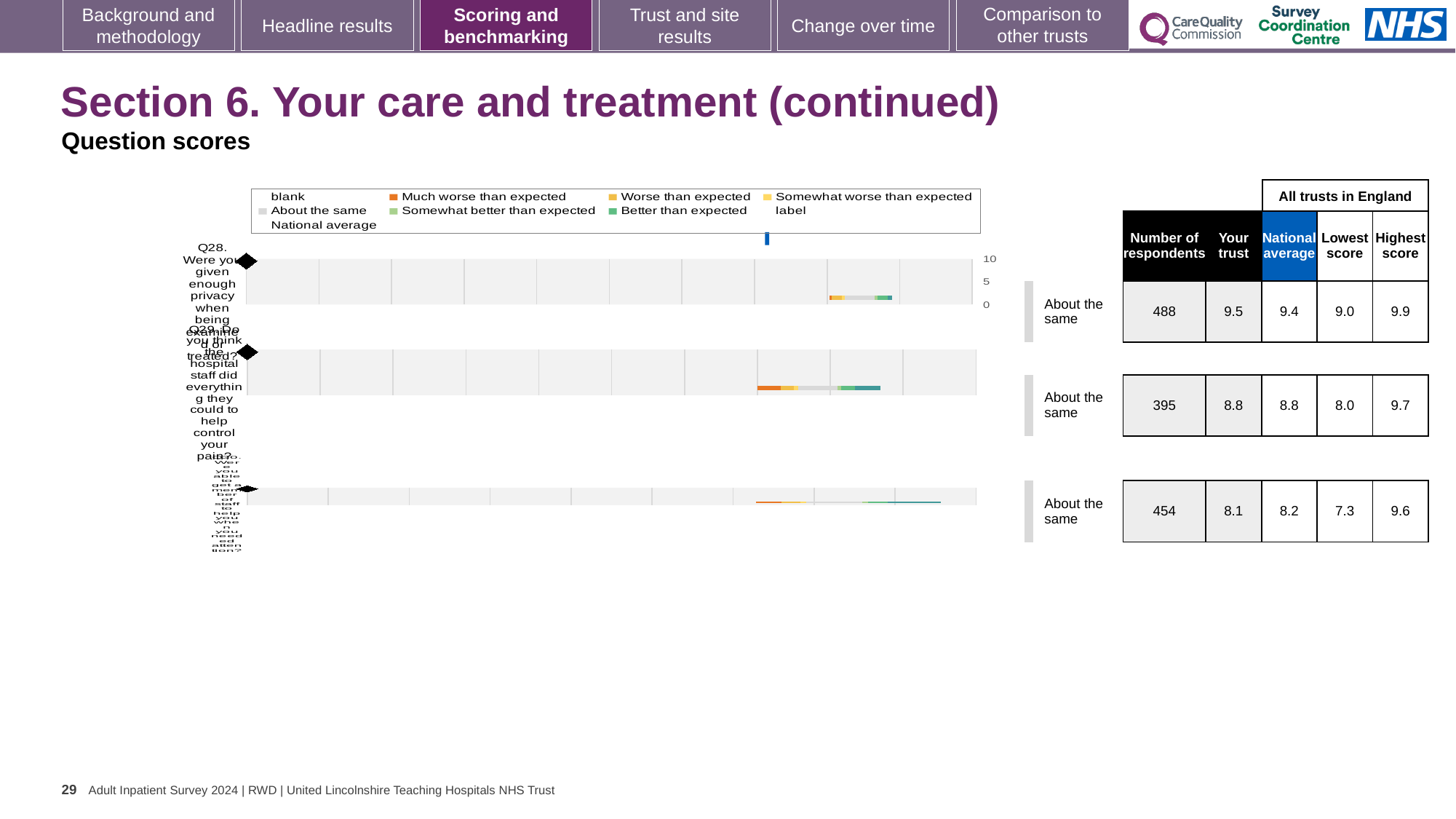
What is the highest score among all trusts in England for Q30, the third question on the slide? 9.6 What is the lowest score among all trusts in England for Q30, the third question on the slide? 7.3 What benchmark category is shown next to the chart for Q29? About the same What kind of chart is used to show the question scores on this slide? Bar chart Which question has the highest 'Your trust' score on this slide? Q28 What is the 'Your trust' score for Q28 (Were you given enough privacy when being examined or treated?)? 9.5 What is the difference between the highest score and the lowest score for Q28? 0.9 For Q30, which is larger: the 'Your trust' score or the national average? National average How many questions are plotted on this slide? 3 How many respondents are listed for Q28? 488 What is the national average score for Q29 (Do you think the hospital staff did everything they could to help control your pain?)? 8.8 Which question has the lowest number of respondents on this slide? Q29